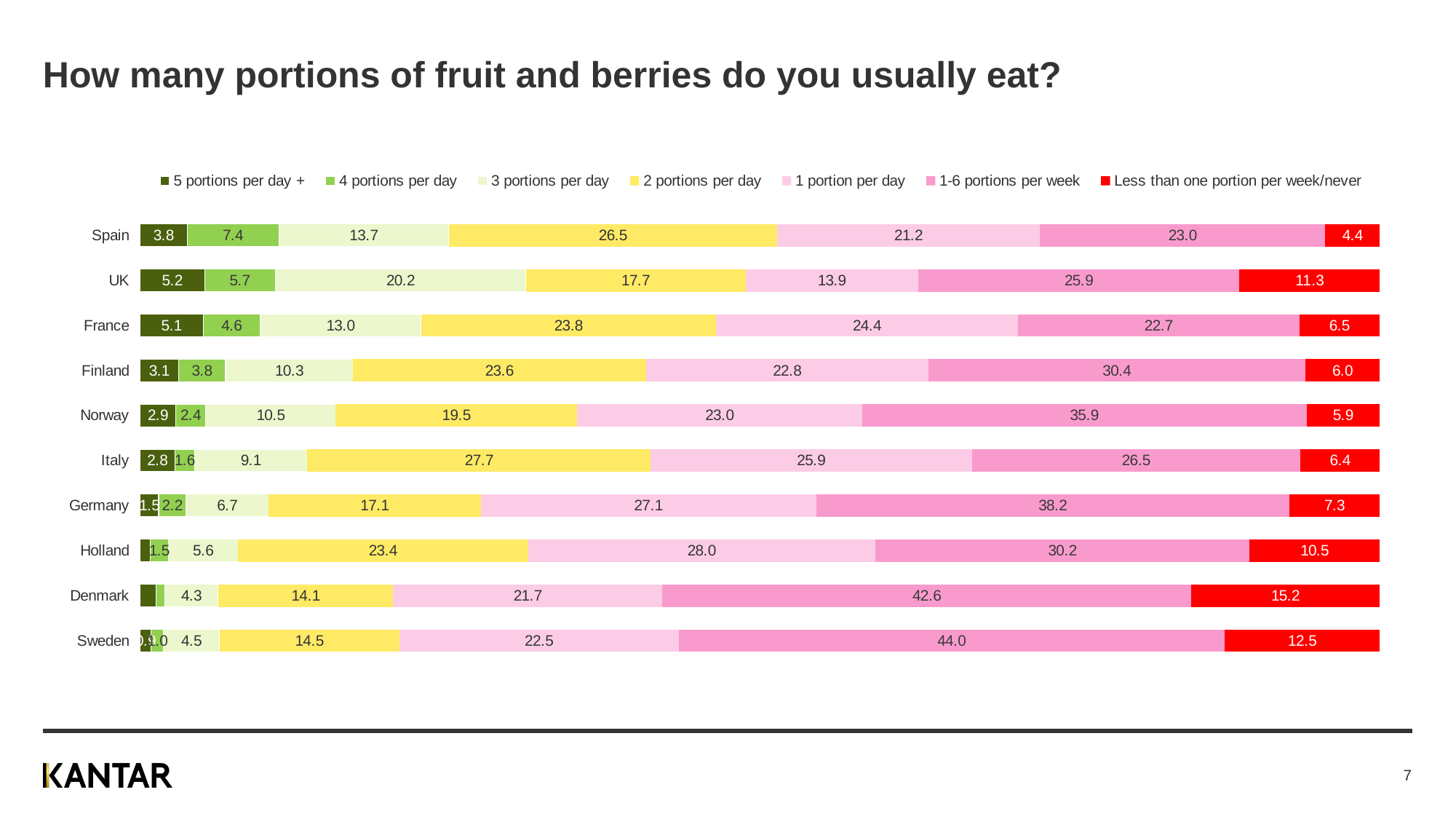
How many series does the legend list? 7 What kind of chart is shown on the slide? Stacked bar chart What is the value for Spain in the "2 portions per day" series? 26.5 What is the value for Norway in the "1 portion per day" series? 23.0 What is the difference between Germany's and Spain's values in the "1-6 portions per week" series? 15.2 Which is larger in the "2 portions per day" series: Italy or France? Italy Which country has the highest value in the "3 portions per day" series? UK How many countries are shown in the chart? 10 Which country has the highest value in the "1-6 portions per week" series? Sweden What is the value for the UK in the "Less than one portion per week/never" series? 11.3 What colour represents the "Less than one portion per week/never" series? Red Which country has the lowest value in the "Less than one portion per week/never" series? Spain